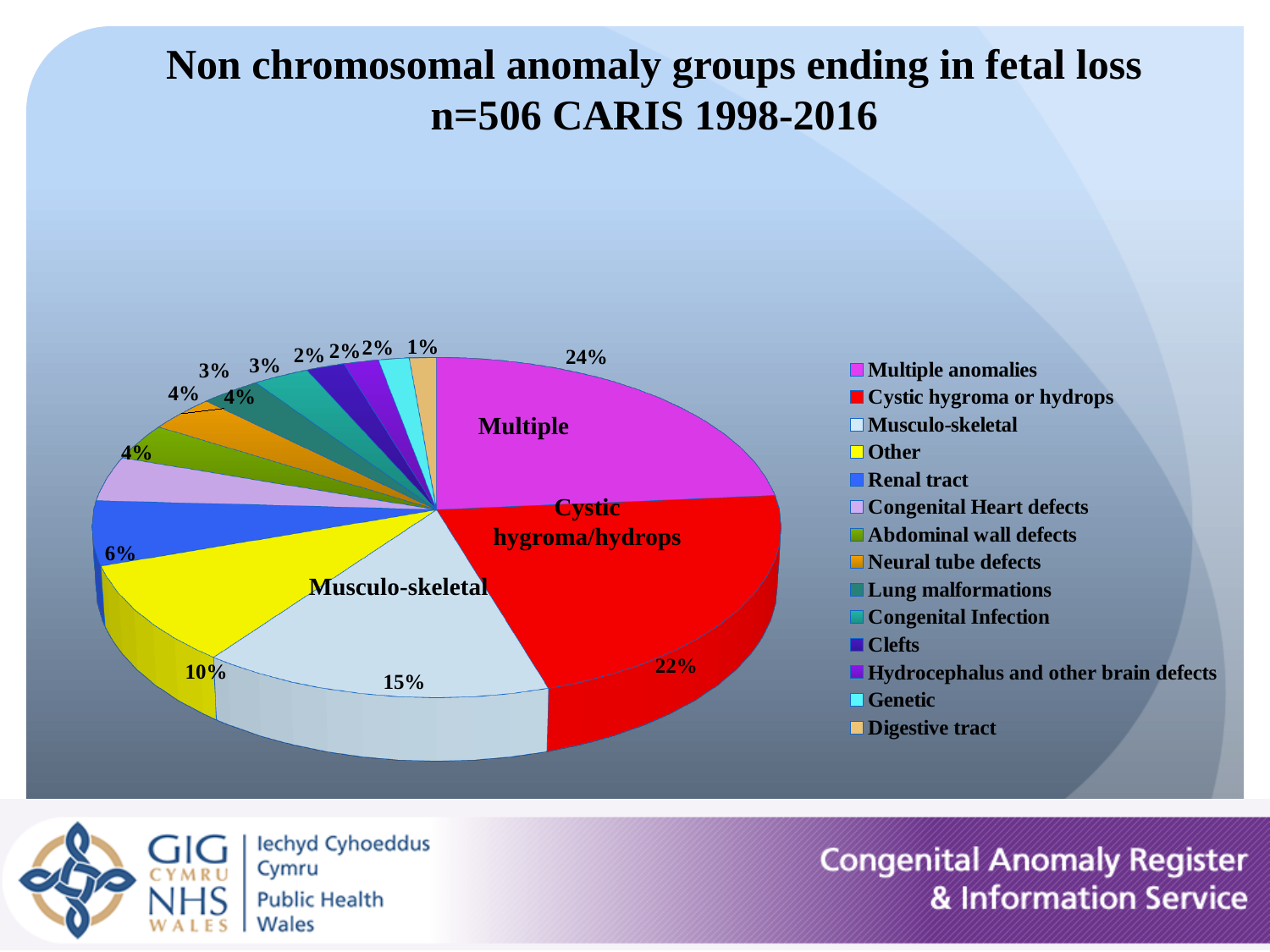
What is the difference in percentage points between Multiple anomalies and Cystic hygroma or hydrops? 2 percentage points What share of the pie is Cystic hygroma or hydrops? 22% What type of chart is shown on the slide? pie chart How many anomaly groups does the legend list? 14 What share of the pie is the Other category? 10% What share of the pie is Multiple anomalies? 24% What is the value of n given in the chart title? 506 Which anomaly group has the largest share of the pie? Multiple anomalies Which anomaly group has the smallest share of the pie? Digestive tract Which is larger, the share for Musculo-skeletal or the share for Other? Musculo-skeletal